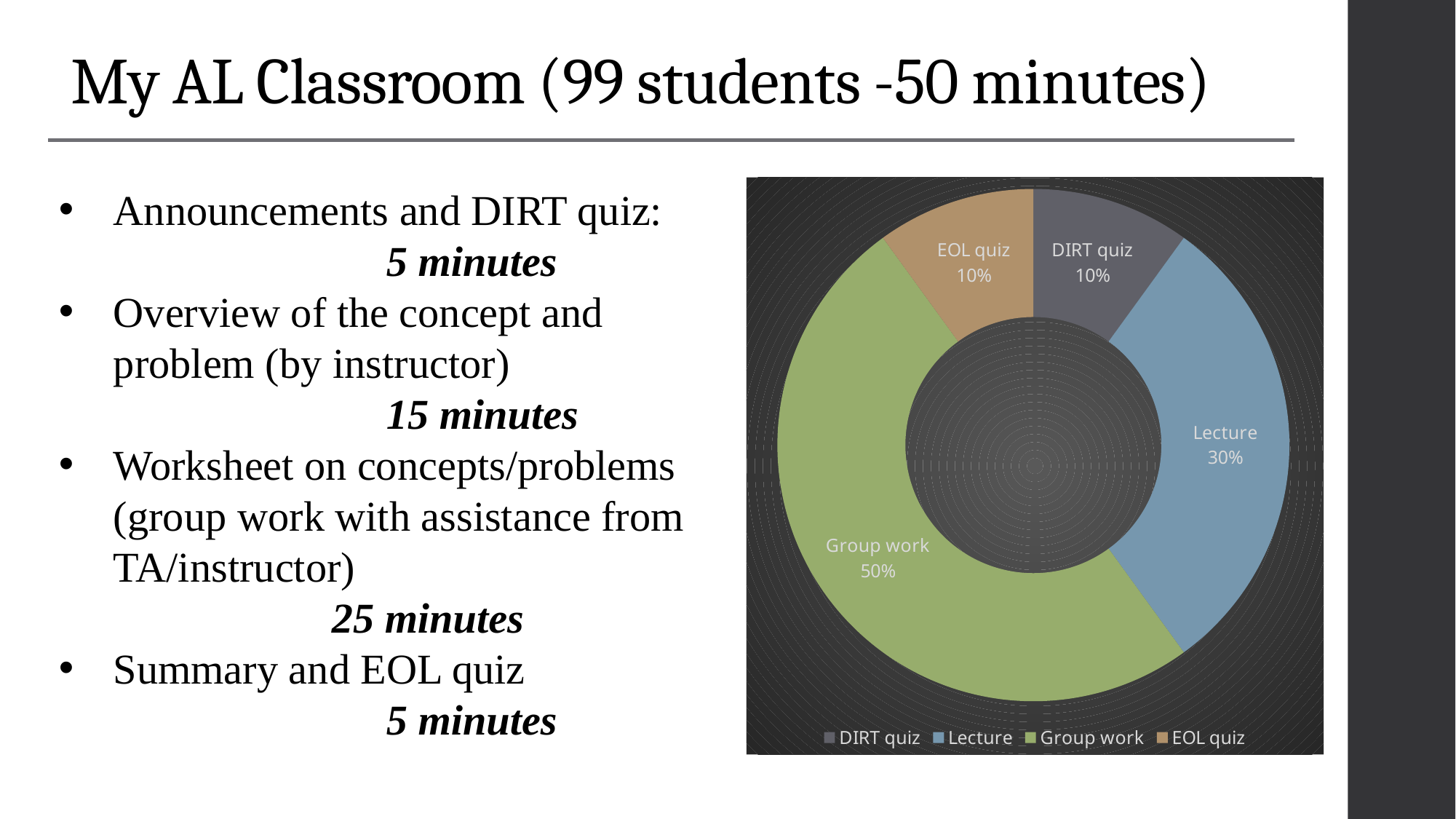
What percentage is shown for the DIRT quiz slice? 10% What kind of chart is shown on the slide? Doughnut (pie) chart What is the difference in percentage points between Group work and Lecture? 20 Which is larger, the Lecture slice or the EOL quiz slice? Lecture Which category is shown in green on the chart? Group work Which category has the largest slice of the chart? Group work What is the combined share of the DIRT quiz and EOL quiz slices? 20% What share of the chart does Group work take? 50% What percentage is shown for the EOL quiz slice? 10% How many categories does the chart show? 4 What are the four entries listed in the chart legend? DIRT quiz, Lecture, Group work, EOL quiz What percentage is shown for Lecture? 30%